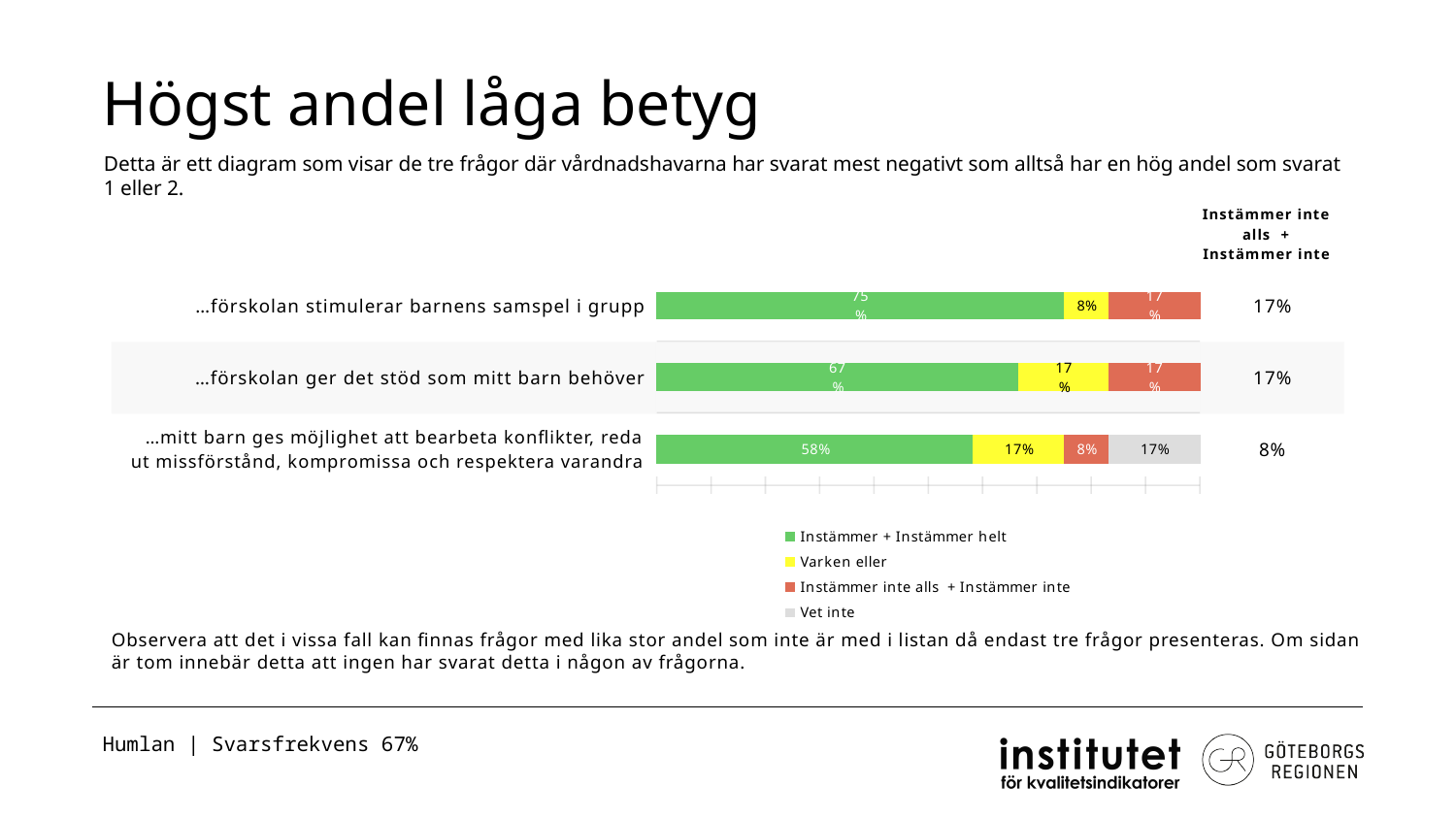
Which category has the lowest "Instämmer + Instämmer helt" value? …mitt barn ges möjlighet att bearbeta konflikter, reda ut missförstånd, kompromissa och respektera varandra What is the difference between the "Instämmer + Instämmer helt" values for "…förskolan stimulerar barnens samspel i grupp" and "…förskolan ger det stöd som mitt barn behöver"? 8% How many categories (questions) are shown in the chart? 3 What kind of chart is shown on the slide? Stacked bar chart How many series does the legend list? 4 What is the value of "Varken eller" for "…förskolan ger det stöd som mitt barn behöver"? 17% What is the value of "Instämmer + Instämmer helt" for "…förskolan stimulerar barnens samspel i grupp"? 75% What is the value of "Vet inte" for "…mitt barn ges möjlighet att bearbeta konflikter, reda ut missförstånd, kompromissa och respektera varandra"? 17% What is the value of "Instämmer + Instämmer helt" for "…mitt barn ges möjlighet att bearbeta konflikter, reda ut missförstånd, kompromissa och respektera varandra"? 58% Which category has the highest "Instämmer + Instämmer helt" value? …förskolan stimulerar barnens samspel i grupp Which is larger: the "Varken eller" value for "…förskolan stimulerar barnens samspel i grupp" or for "…förskolan ger det stöd som mitt barn behöver"? …förskolan ger det stöd som mitt barn behöver What value is shown in the "Instämmer inte alls + Instämmer inte" column for "…mitt barn ges möjlighet att bearbeta konflikter, reda ut missförstånd, kompromissa och respektera varandra"? 8%